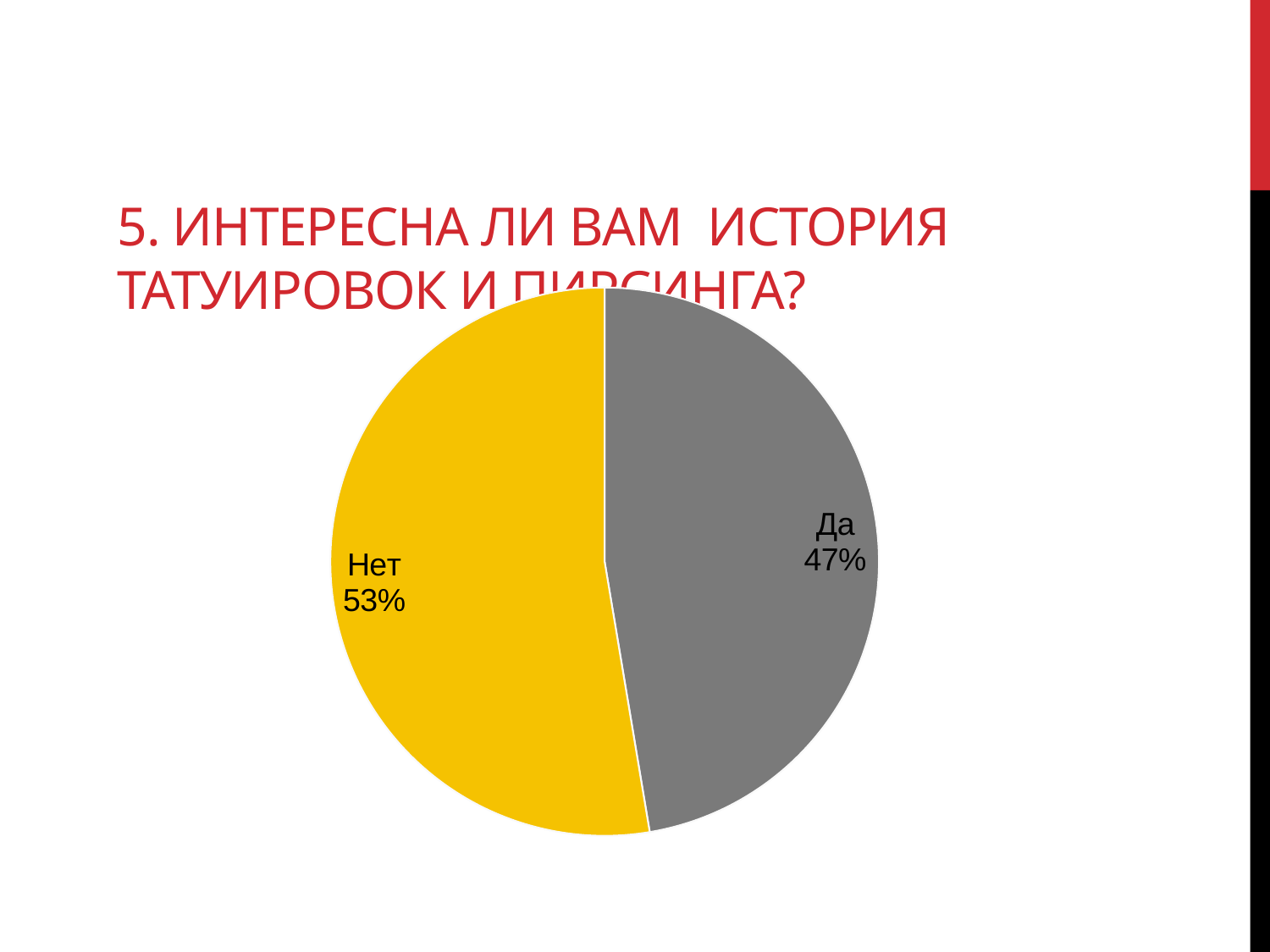
What share of the pie does the "Да" slice represent? 47% How many slices does the pie chart have? 2 Which slice of the pie is the largest? Нет What percentage of the pie is labelled "Да"? 47% Which is larger, the "Да" slice or the "Нет" slice? Нет What colour is the "Да" slice of the pie? grey What kind of chart is shown on the slide? pie chart What percentage of the pie is labelled "Нет"? 53% What colour is the "Нет" slice of the pie? yellow What is the difference in percentage points between the "Нет" and "Да" slices? 6 Which slice of the pie is the smallest? Да